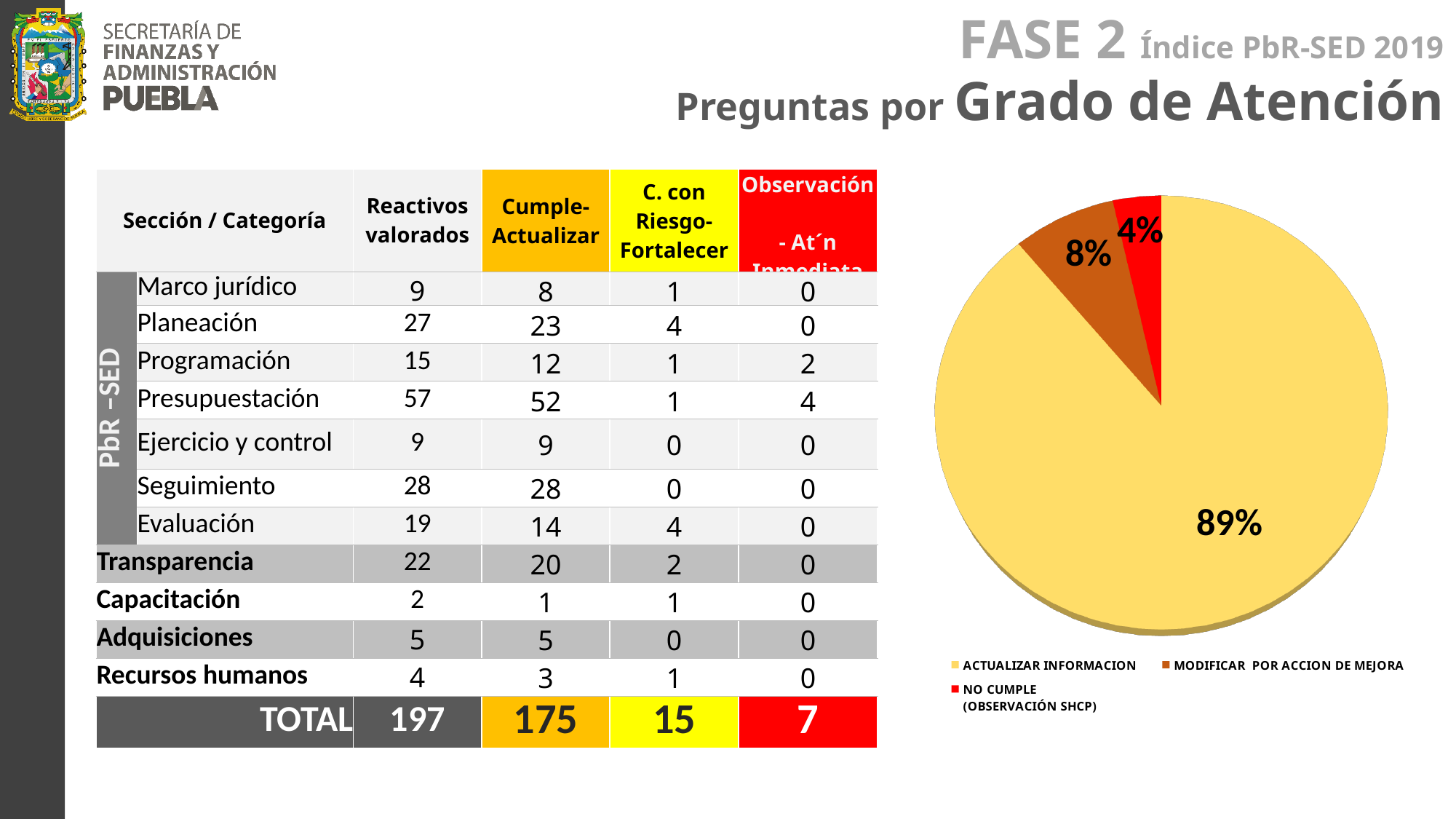
In the pie chart, what percentage is shown for ACTUALIZAR INFORMACION? 89% What is the difference in percentage points between the ACTUALIZAR INFORMACION slice and the MODIFICAR POR ACCION DE MEJORA slice? 81 In the pie chart, what percentage is shown for MODIFICAR POR ACCION DE MEJORA? 8% What type of chart is shown on the slide? pie chart Which slice of the pie chart is the smallest? NO CUMPLE (OBSERVACIÓN SHCP) Which slice of the pie chart is the largest? ACTUALIZAR INFORMACION In the pie chart, which is larger: MODIFICAR POR ACCION DE MEJORA or NO CUMPLE (OBSERVACIÓN SHCP)? MODIFICAR POR ACCION DE MEJORA What colour is the NO CUMPLE (OBSERVACIÓN SHCP) slice in the pie chart? red How many slices does the pie chart have? 3 How many entries does the pie chart's legend list? 3 What is the difference in percentage points between the MODIFICAR POR ACCION DE MEJORA slice and the NO CUMPLE (OBSERVACIÓN SHCP) slice? 4 In the pie chart, what percentage is shown for NO CUMPLE (OBSERVACIÓN SHCP)? 4%